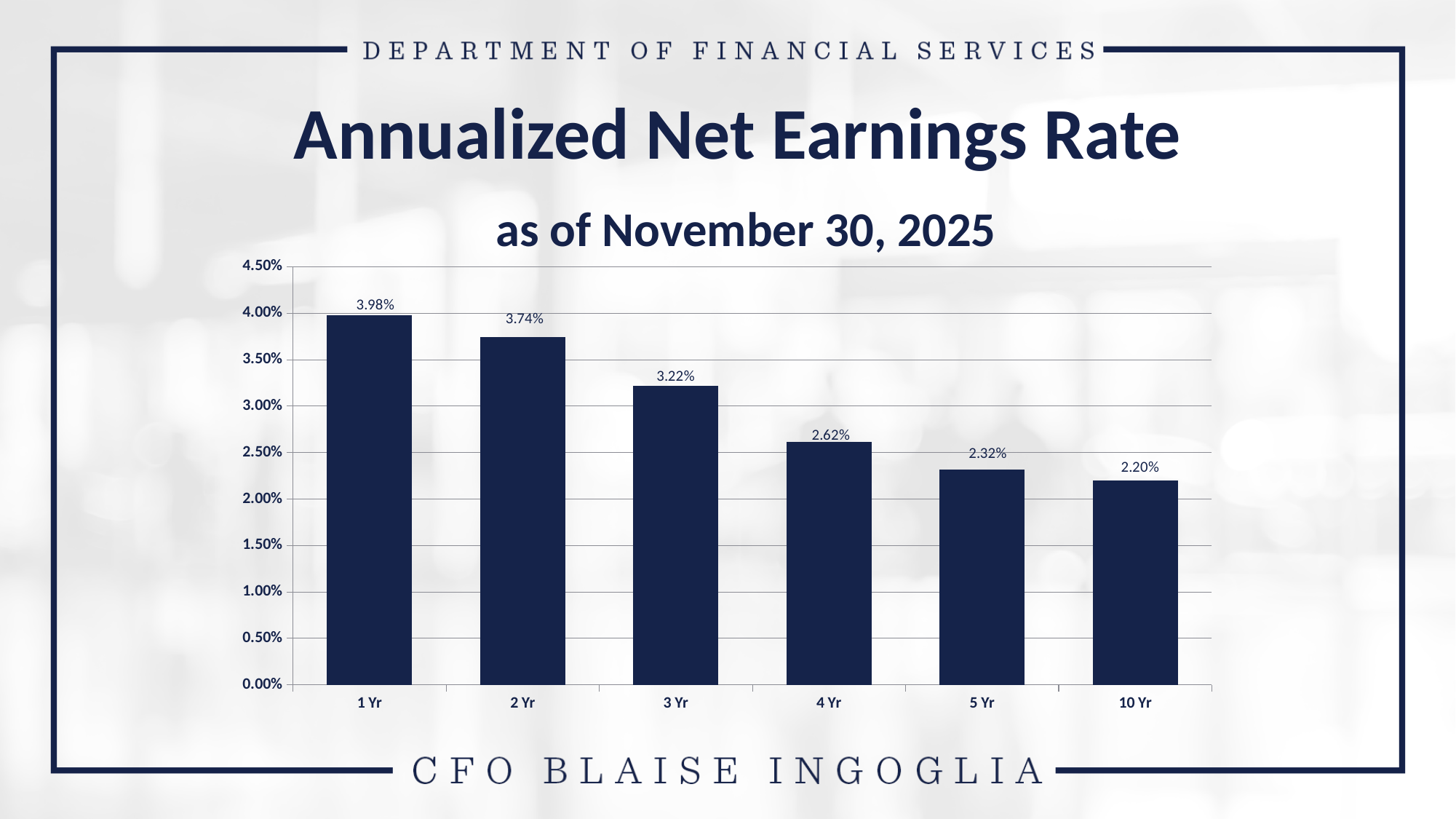
How many periods are shown on the x axis? 6 What is the difference between the 4 Yr and 5 Yr annualized net earnings rates? 0.30% Which period has the lowest annualized net earnings rate? 10 Yr What is the annualized net earnings rate for 1 Yr? 3.98% Which is larger, the rate for 2 Yr or the rate for 4 Yr? 2 Yr Is the value for 3 Yr greater or less than 3.00%? greater What is the annualized net earnings rate for 10 Yr? 2.20% What is the difference between the 1 Yr and 2 Yr annualized net earnings rates? 0.24% What is the annualized net earnings rate for 3 Yr? 3.22% Which period has the highest annualized net earnings rate? 1 Yr What kind of chart is shown on the slide? bar chart Do the values rise or fall as the period lengthens from 1 Yr to 10 Yr? fall